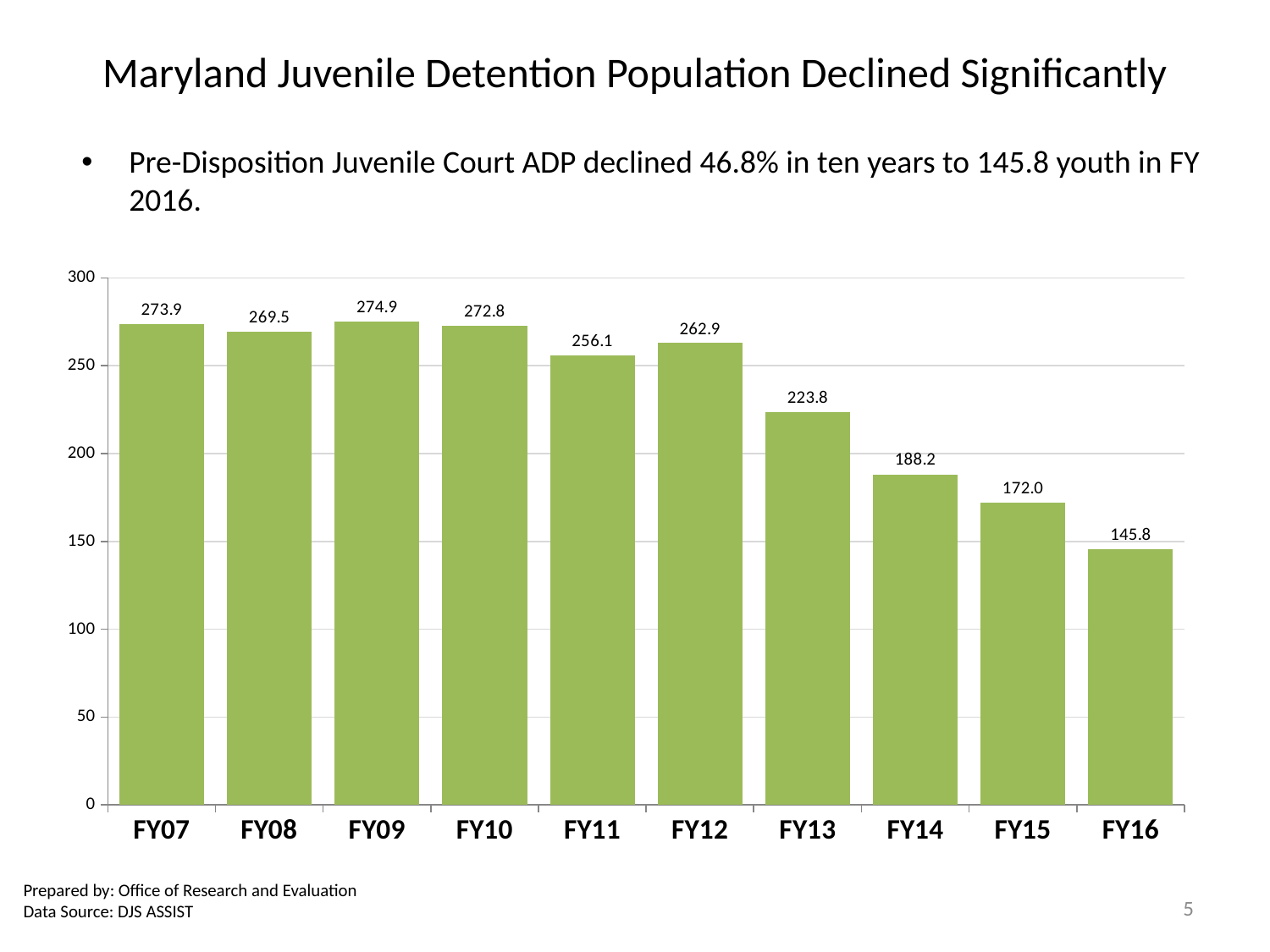
How many fiscal years are shown on the x axis? 10 What is the value for FY13? 223.8 What kind of chart is shown on the slide? bar chart Do the values generally rise or fall from FY07 to FY16? fall What is the difference between the values for FY07 and FY16? 128.1 Is the value for FY13 greater or less than 200? greater Which is larger, the value for FY11 or the value for FY12? FY12 What is the difference between the values for FY14 and FY15? 16.2 Which fiscal year has the highest value? FY09 Which fiscal year has the lowest value? FY16 What is the value for FY07? 273.9 What is the value for FY16? 145.8